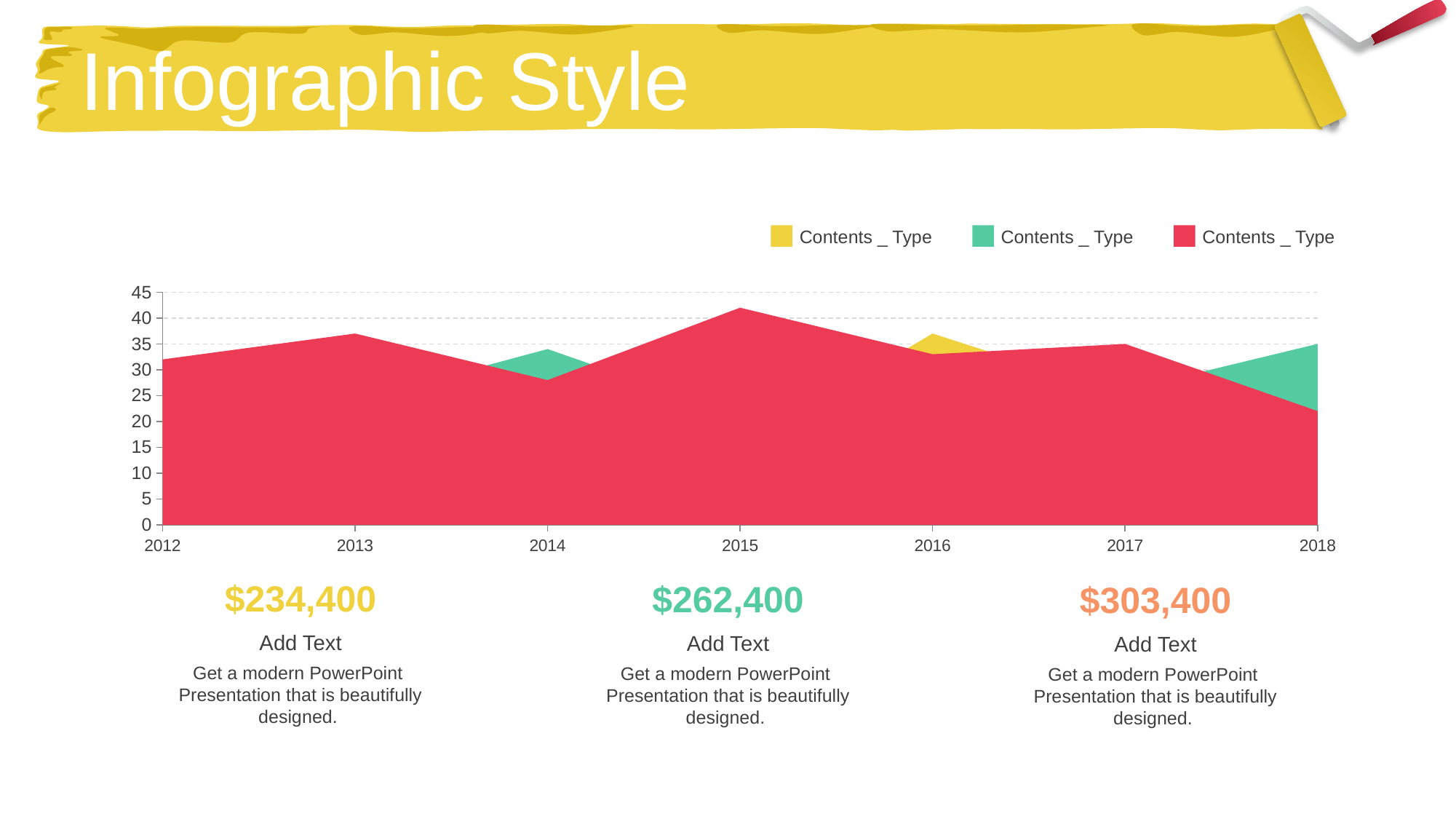
Is the value of the green series in 2018 greater or less than 30? greater What kind of chart is shown on the slide? Area chart Is the value of the red series in 2018 greater or less than 25? less What label is used for each of the three legend entries? Contents _ Type How many series does the chart legend list? 3 In which year does the red series reach its lowest value? 2018 Is the value of the red series in 2014 greater or less than 30? less Does the red series rise or fall from 2017 to 2018? Fall In which year does the red series reach its highest value? 2015 How many years are shown along the x axis of the chart? 7 Which year has the larger value for the red series, 2014 or 2015? 2015